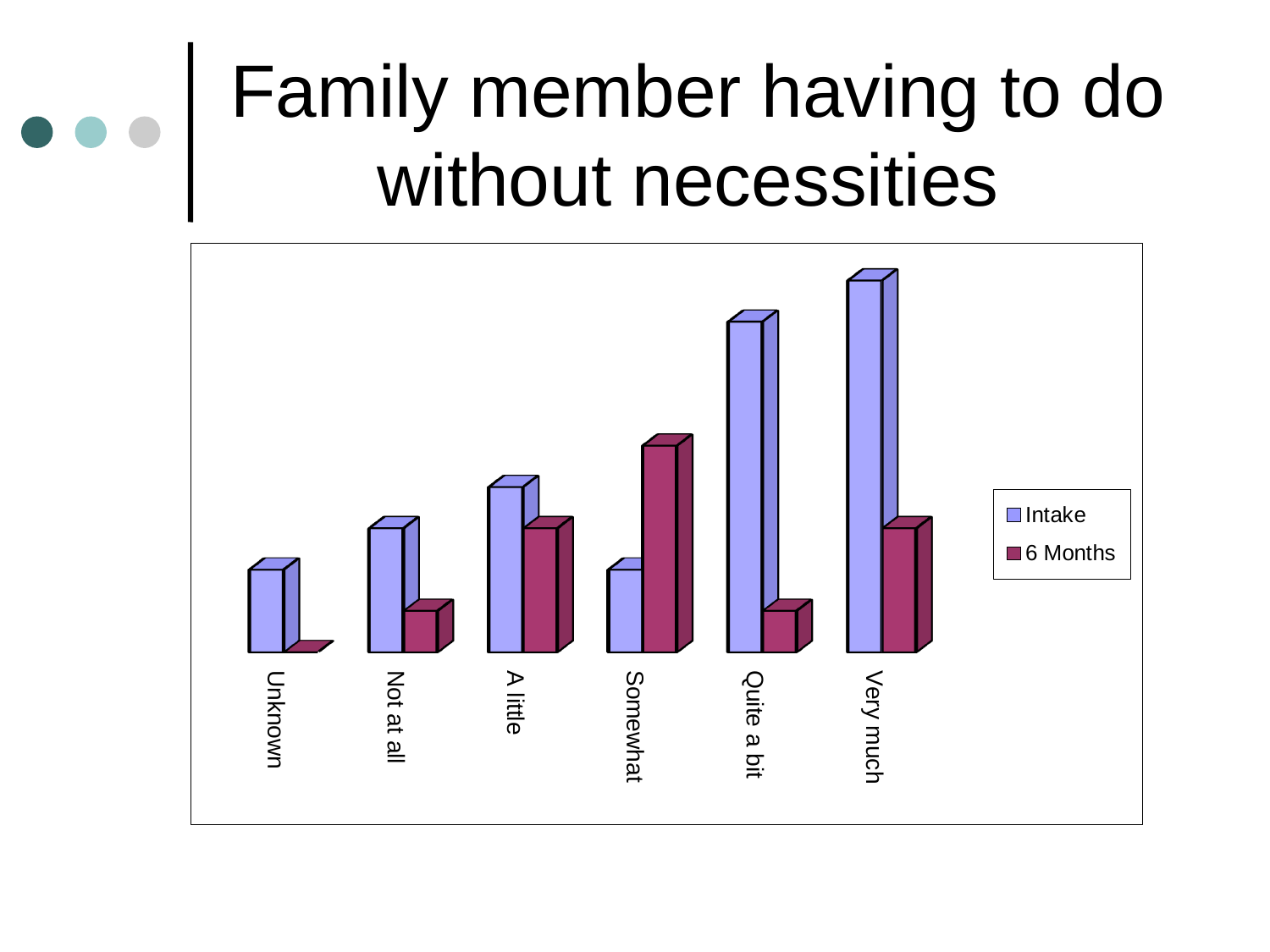
Which is larger: the Intake value for Quite a bit or the Intake value for A little? Quite a bit What kind of chart is shown on the slide? Bar chart What are the two series named in the legend? Intake and 6 Months Which category has the lowest 6 Months value? Unknown For the Somewhat category, which is larger: Intake or 6 Months? 6 Months What is the title of the slide containing the chart? Family member having to do without necessities How many series does the legend list? 2 Which category has the highest Intake value? Very much For the Very much category, which is larger: Intake or 6 Months? Intake Which category has the highest 6 Months value? Somewhat How many categories are shown along the x axis? 6